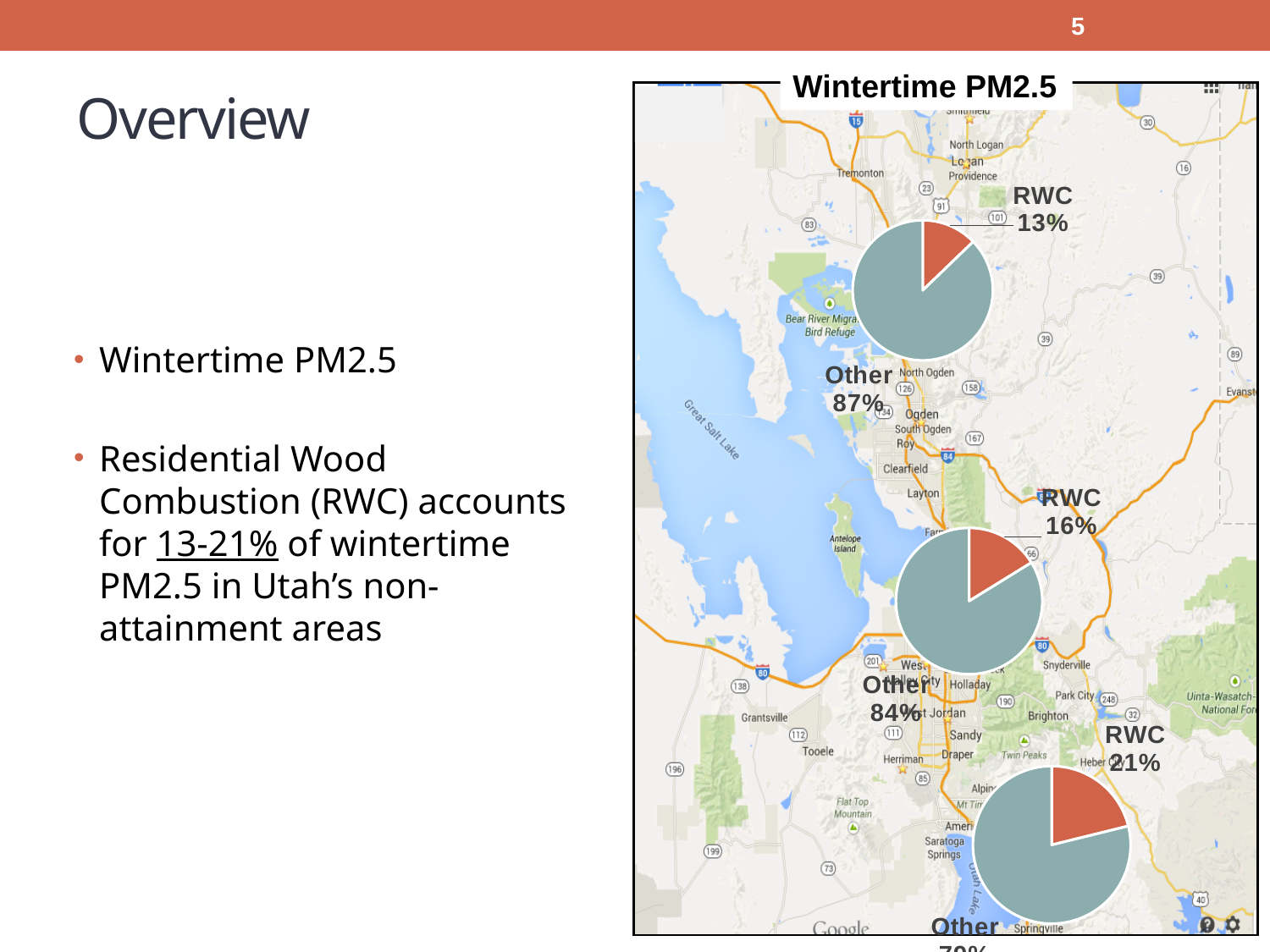
What is the title shown above the map with the pie charts? Wintertime PM2.5 In the middle pie chart, what share is labelled Other? 84% In the middle pie chart, what share is labelled RWC? 16% How many pie charts are shown on the map? 3 Which of the three pie charts has the smallest RWC share? The top pie chart In the top pie chart, which slice is larger, RWC or Other? Other What kind of chart is the top chart on the map? Pie chart In the bottom pie chart, what share is labelled RWC? 21% In the top pie chart, what share is labelled Other? 87% How many percentage points larger is the RWC share in the bottom pie chart than in the top pie chart? 8 percentage points In the top pie chart, what share is labelled RWC? 13% Which of the three pie charts has the largest RWC share? The bottom pie chart